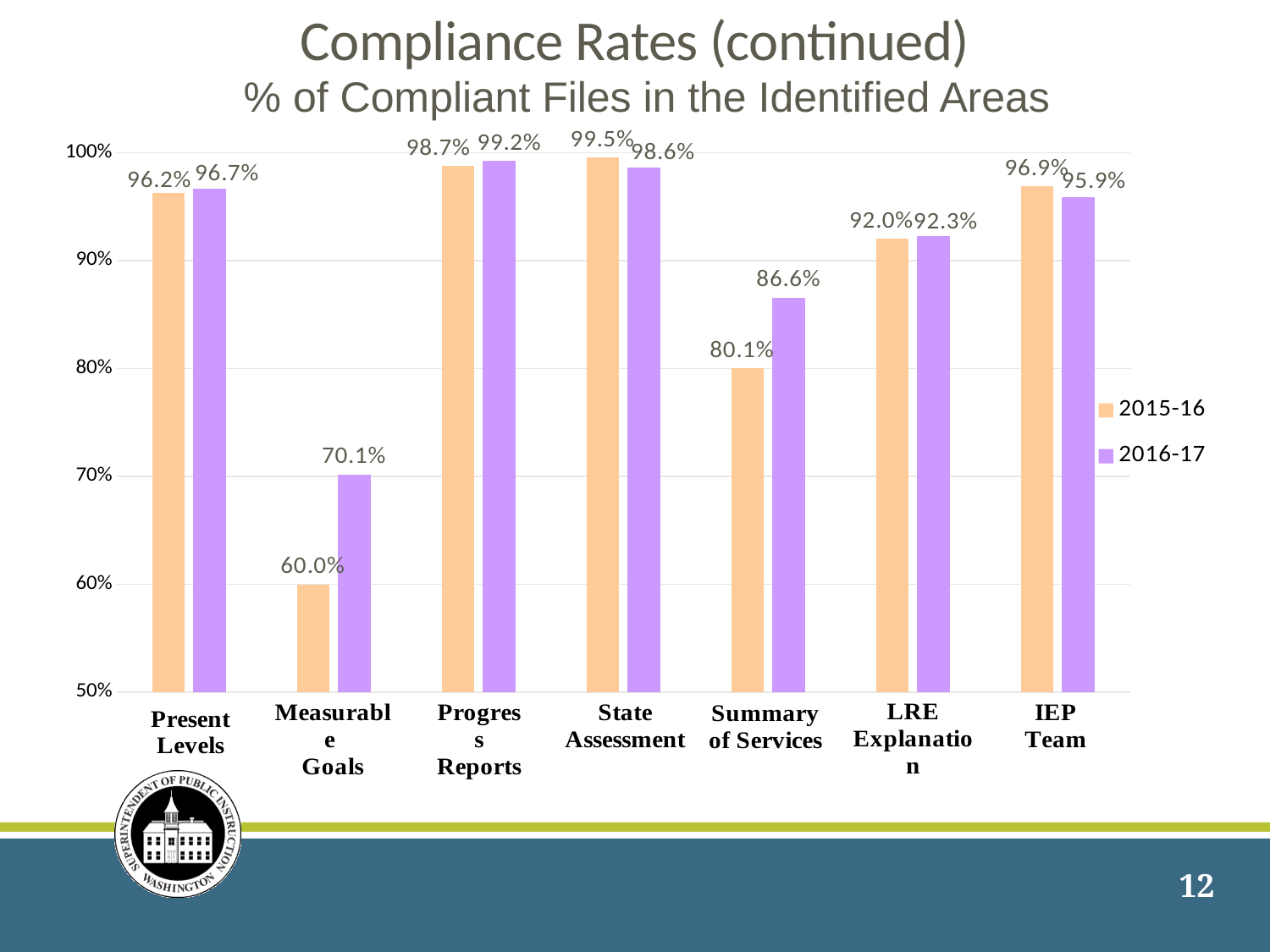
What is the 2015-16 value for Measurable Goals? 60.0% Which is larger for IEP Team: the 2015-16 value or the 2016-17 value? 2015-16 Is the 2015-16 value for Summary of Services greater or less than 90%? less How many categories are shown on the x axis? 7 Which category has the highest 2015-16 value? State Assessment What is the difference between the 2016-17 and 2015-16 values for Summary of Services? 6.5% What is the difference between the 2016-17 and 2015-16 values for Measurable Goals? 10.1% What is the 2015-16 value for State Assessment? 99.5% What is the 2016-17 value for Summary of Services? 86.6% Which category has the lowest 2016-17 value? Measurable Goals What kind of chart is shown on the slide? bar chart How many series does the legend list? 2